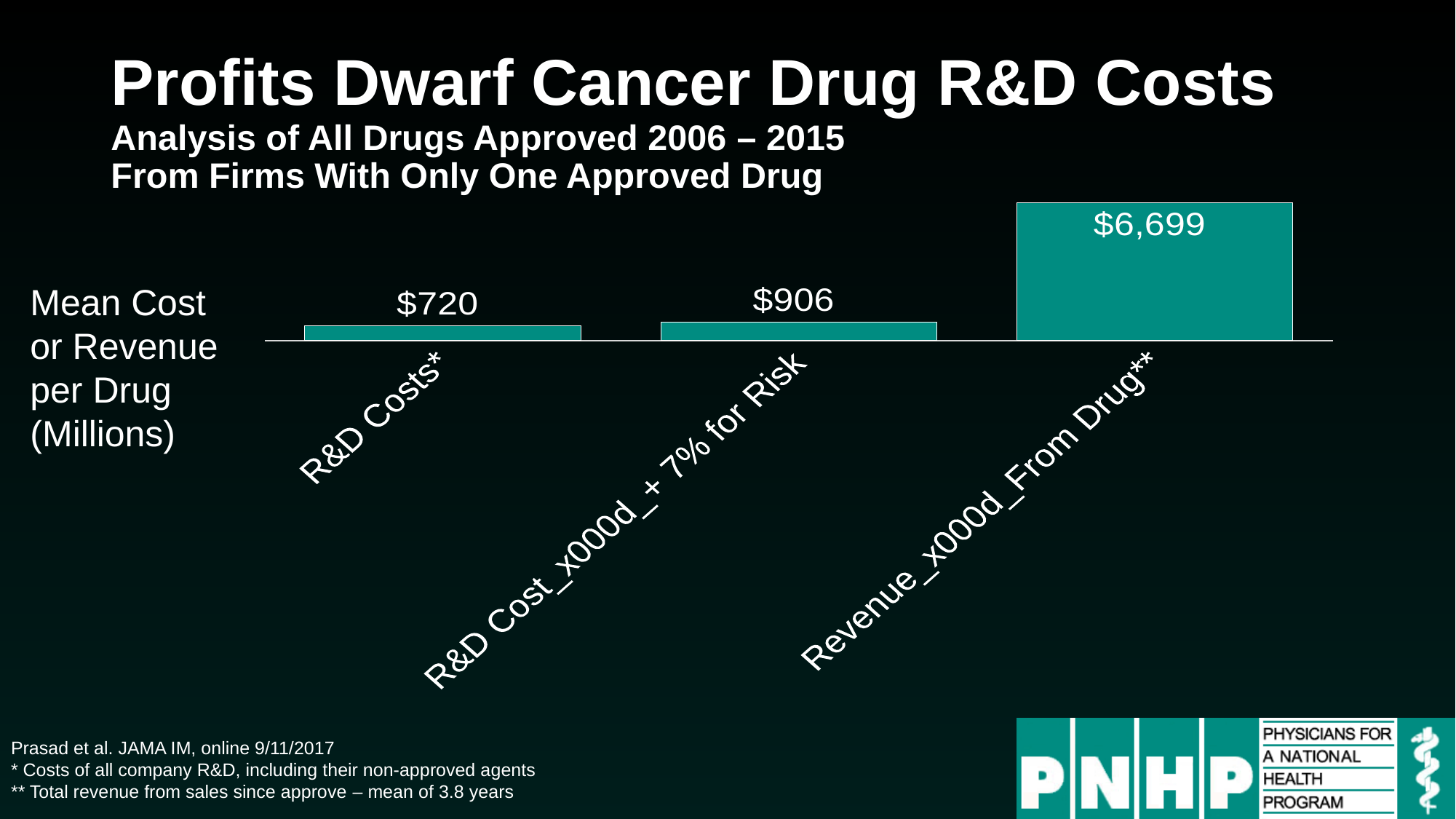
What is the value of the R&D Costs* bar? $720 Do the values rise or fall from left to right across the bars? Rise How many bars are shown in the chart? 3 Which category has the highest value? Revenue From Drug** What is the difference between the R&D Cost + 7% for Risk bar and the R&D Costs* bar? $186 What is the value of the middle bar, labelled R&D Cost + 7% for Risk? $906 Which category has the lowest value? R&D Costs* What is the value of the Revenue From Drug** bar? $6,699 Which is larger, the R&D Costs* bar or the R&D Cost + 7% for Risk bar? R&D Cost + 7% for Risk What type of chart is shown on the slide? Bar chart What is the title of the slide containing the chart? Profits Dwarf Cancer Drug R&D Costs What is the difference between the Revenue From Drug** bar and the R&D Costs* bar? $5,979